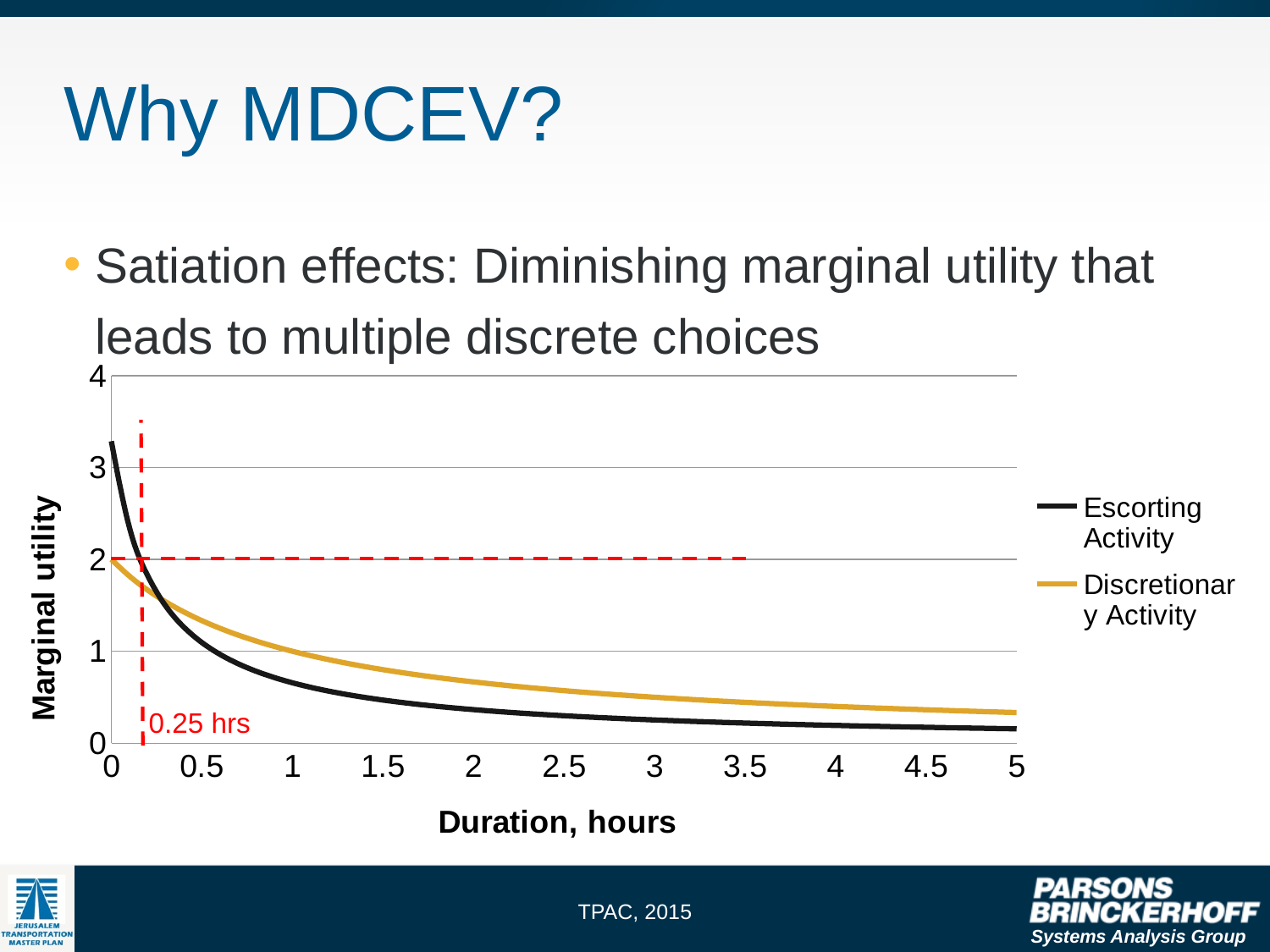
Is the marginal utility of the Discretionary Activity at a duration of 5 hours greater or less than 1? less At a duration of 0 hours, which series has the higher marginal utility, Escorting Activity or Discretionary Activity? Escorting Activity Does the marginal utility of the Discretionary Activity rise or fall as duration increases? fall Does the marginal utility of the Escorting Activity rise or fall as duration increases? fall What is the title of the chart's y axis? Marginal utility Is the marginal utility of the Escorting Activity at a duration of 1 hour greater or less than 1? less What duration is marked by the red dashed vertical line on the chart? 0.25 hrs What is the title of the chart's x axis? Duration, hours How many series does the chart legend list? 2 What kind of chart is shown on the slide? line chart At a duration of 3 hours, which series has the higher marginal utility, Escorting Activity or Discretionary Activity? Discretionary Activity Is the marginal utility of the Escorting Activity at a duration of 0 hours greater or less than 3? greater